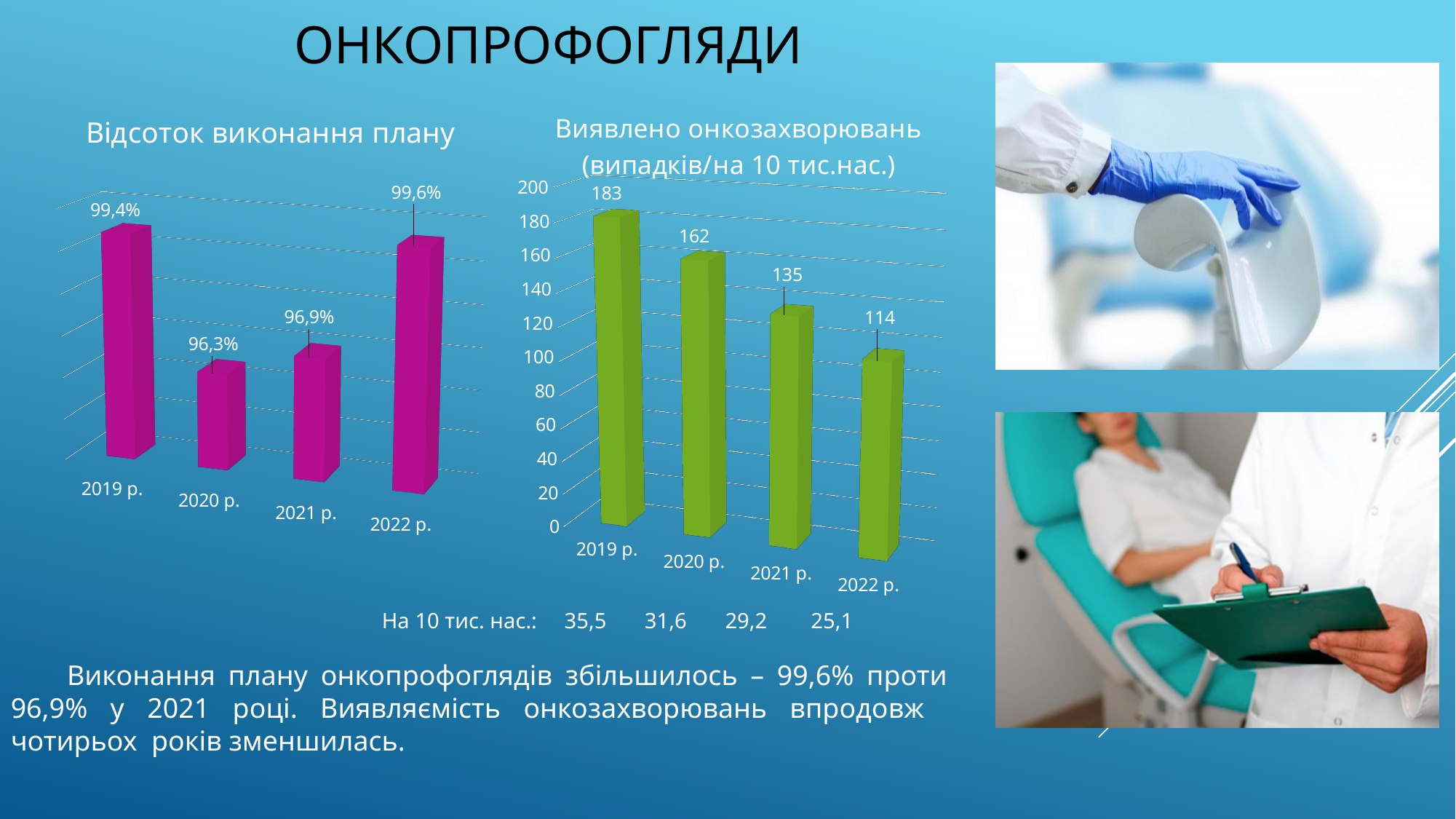
What kind of chart is the chart titled "Виявлено онкозахворювань"? bar chart In the chart titled "Виявлено онкозахворювань", what is the difference between the values for 2019 р. and 2022 р.? 69 In the chart titled "Відсоток виконання плану", which year has the lowest value? 2020 р. In the chart titled "Відсоток виконання плану", how many years are shown? 4 In the chart titled "Відсоток виконання плану", what is the value for 2019 р.? 99,4% In the chart titled "Відсоток виконання плану", which year has the highest value? 2022 р. In the chart titled "Виявлено онкозахворювань", which year has the highest value? 2019 р. In the chart titled "Виявлено онкозахворювань", do the values rise or fall from 2019 р. to 2022 р.? fall In the chart titled "Виявлено онкозахворювань", what is the value for 2022 р.? 114 In the chart titled "Відсоток виконання плану", what is the value for 2021 р.? 96,9% In the chart titled "Виявлено онкозахворювань", what is the value for 2020 р.? 162 In the chart titled "Виявлено онкозахворювань", is the value for 2021 р. greater or less than 140? less